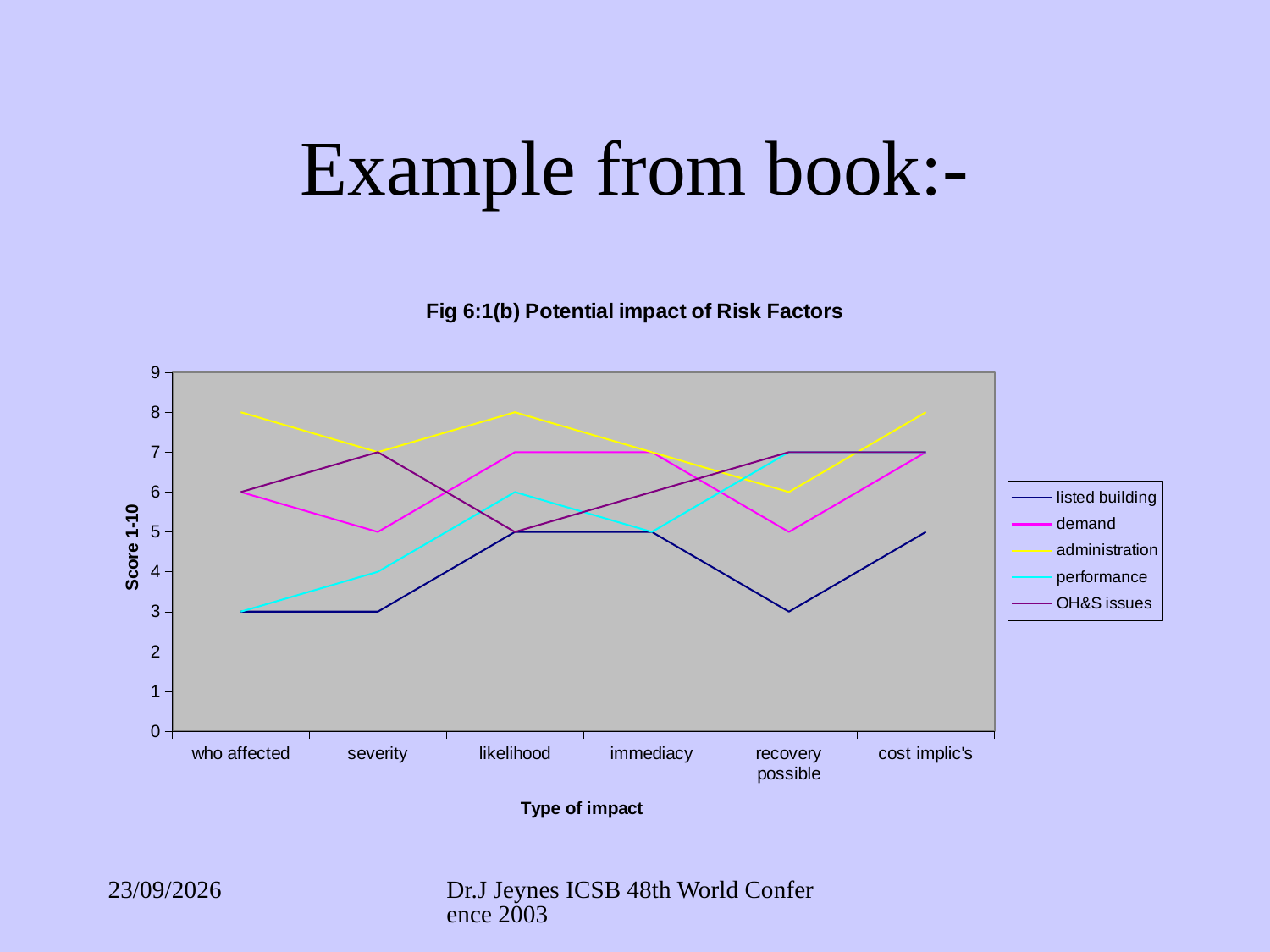
Which series has the highest score at 'likelihood'? administration How many types of impact are shown along the x axis? 6 What is the score for administration at 'who affected'? 8 Which series has the lowest score at 'who affected'? listed building and performance What is the score for listed building at 'recovery possible'? 3 What is the score for performance at 'severity'? 4 What kind of chart is shown on the slide? line chart At 'immediacy', which is larger: the demand score or the performance score? demand What is the difference between the administration score and the listed building score at 'cost implic's'? 3 What is the title of the chart? Fig 6:1(b) Potential impact of Risk Factors How many series does the legend list? 5 Is the score for OH&S issues at 'severity' greater or less than 5? greater